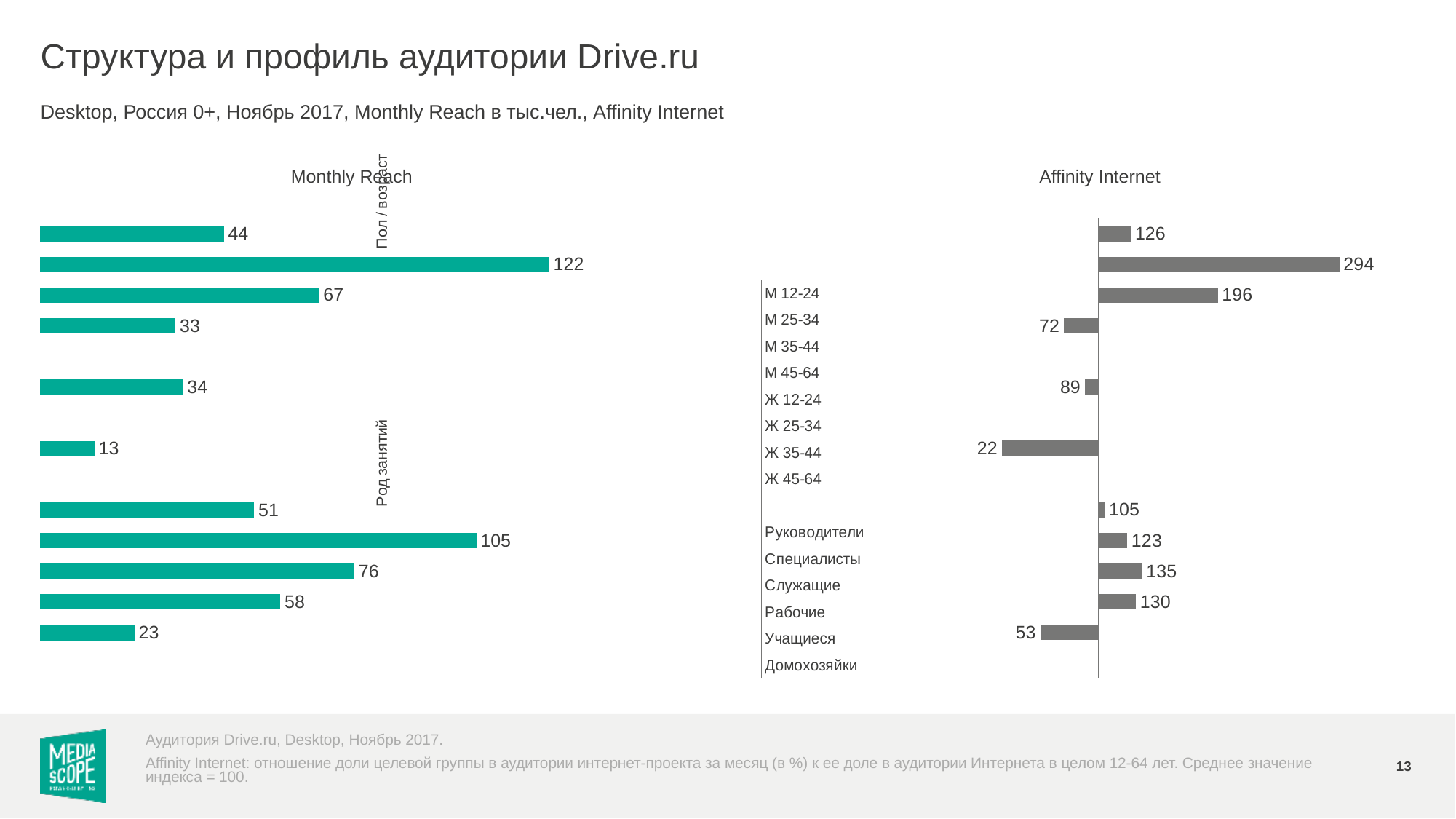
In the Monthly Reach chart, what is the difference between the highest value (122) and the lowest value (13)? 109 In the Monthly Reach chart, which is larger: the bar labelled 122 or the bar labelled 105? 122 In the Affinity Internet chart, what is the lowest value shown? 22 How many data labels are printed on the Monthly Reach chart? 11 How many bars in the Affinity Internet chart extend to the left of the vertical axis line? 4 What is the title of the chart on the right side of the slide? Affinity Internet What colour are the bars in the Monthly Reach chart? teal (green) In the Affinity Internet chart, what is the highest value shown? 294 In the Affinity Internet chart, what is the difference between the two largest values, 294 and 196? 98 In the Monthly Reach chart, what is the highest value shown? 122 In the Monthly Reach chart, what is the lowest value shown? 13 What kind of chart is the Monthly Reach chart? bar chart